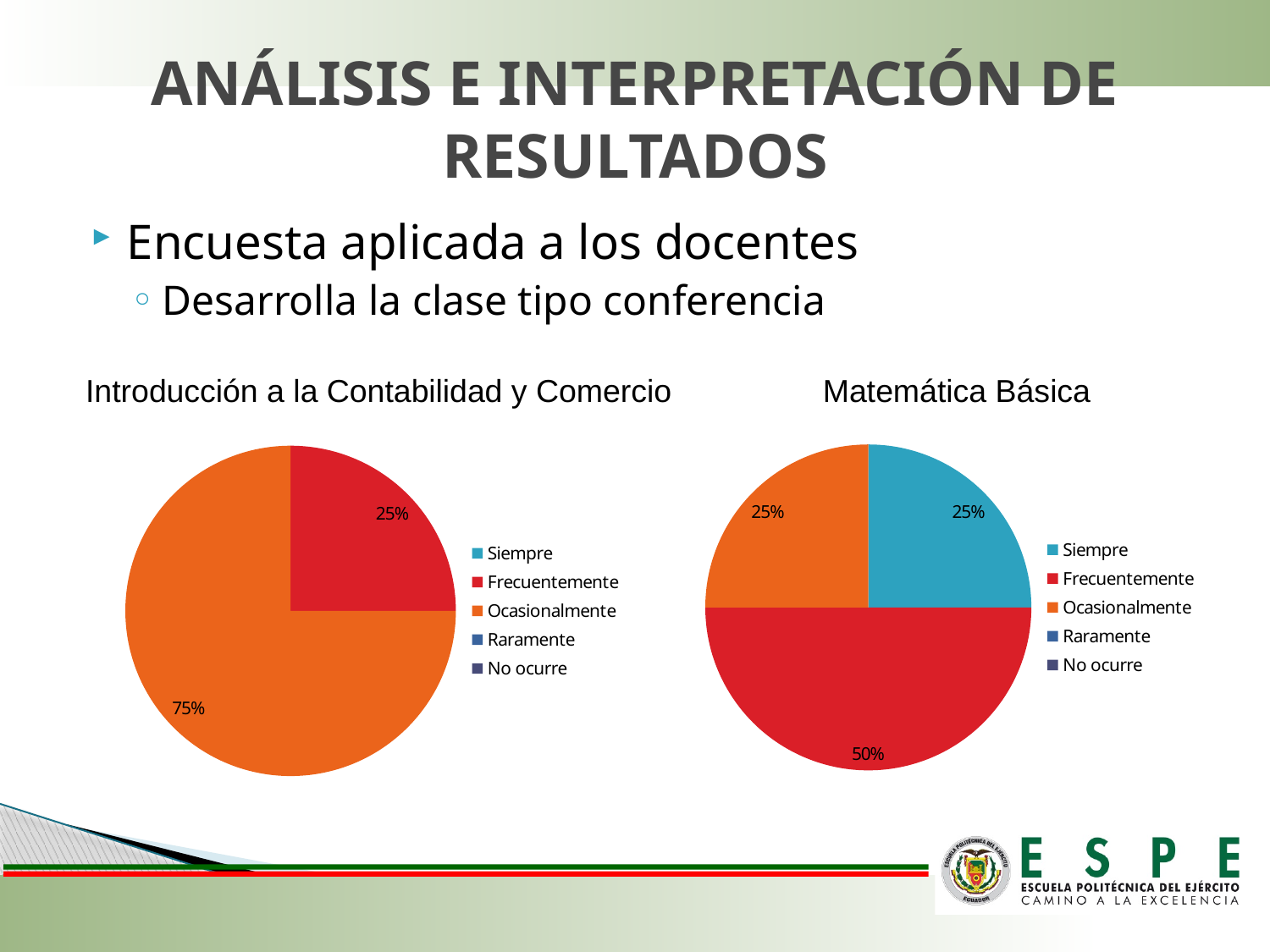
In the 'Matemática Básica' chart, what share does Siempre have? 25% In the 'Matemática Básica' chart, which category has the largest slice? Frecuentemente In the 'Introducción a la Contabilidad y Comercio' chart, what share does Ocasionalmente have? 75% In the 'Introducción a la Contabilidad y Comercio' chart, what share does Frecuentemente have? 25% In the 'Introducción a la Contabilidad y Comercio' chart, what is the difference between the Ocasionalmente and Frecuentemente shares? 50% What kind of chart is the 'Matemática Básica' chart? Pie chart In the 'Introducción a la Contabilidad y Comercio' chart, which category has the largest slice? Ocasionalmente How many entries does the legend of the 'Introducción a la Contabilidad y Comercio' chart list? 5 In the 'Matemática Básica' chart, what share does Ocasionalmente have? 25% In the 'Matemática Básica' chart, what share does Frecuentemente have? 50% In the 'Matemática Básica' chart, which is larger, Frecuentemente or Siempre? Frecuentemente In the 'Matemática Básica' chart, what colour is the Siempre slice? Blue